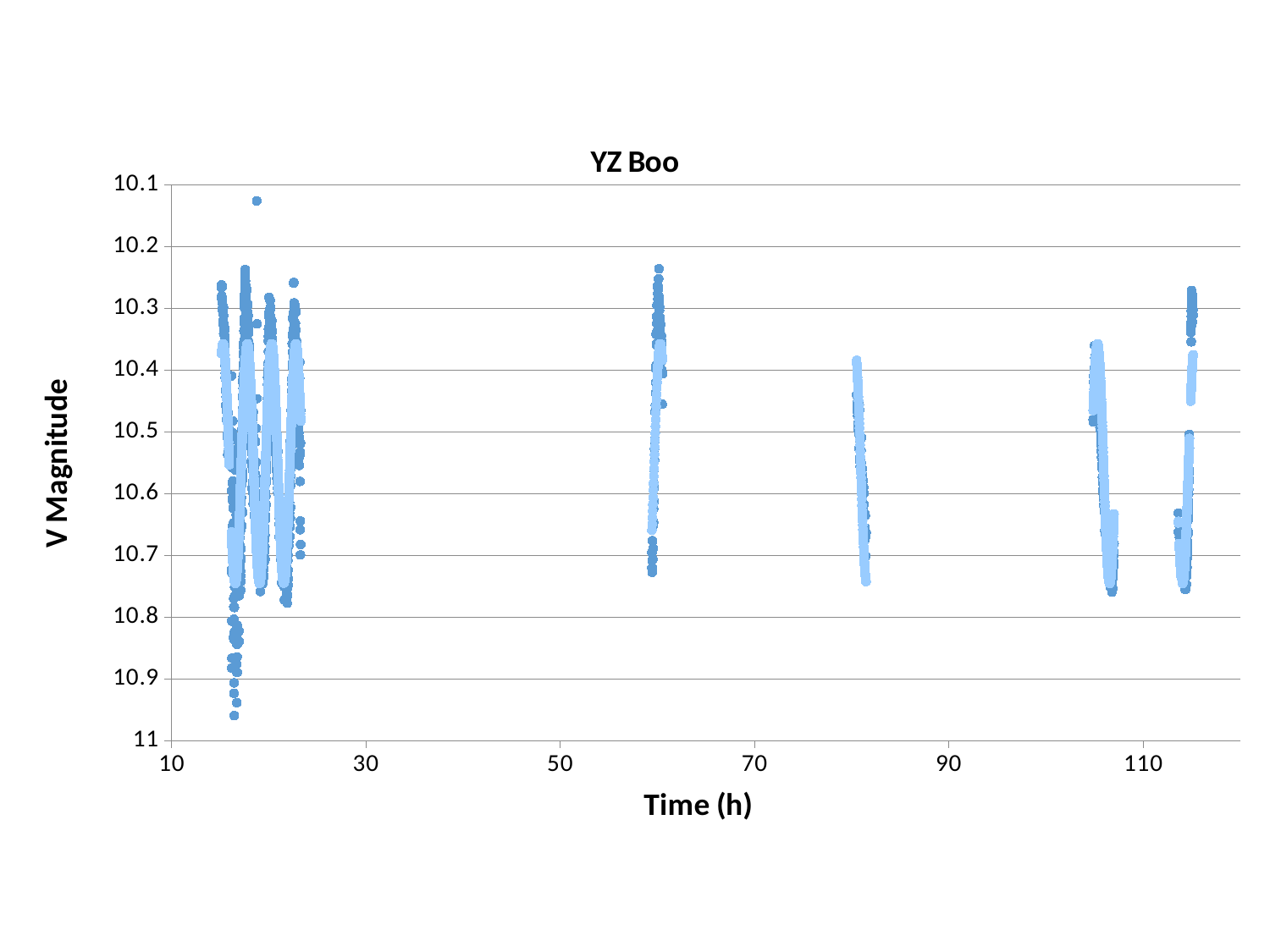
Is the smallest V Magnitude value in the group of points near 114 h greater or less than 10.2? greater Which group of points reaches a larger V Magnitude value, the one near 16 h or the one near 81 h? the one near 16 h Is the largest V Magnitude value in the group of points near 81 h greater or less than 10.7? greater Is the smallest V Magnitude value in the group of points near 81 h greater or less than 10.3? greater What is the label of the vertical axis? V Magnitude What kind of chart is shown on the slide? scatter chart What is the title of the chart? YZ Boo How many separate groups of observations are plotted along the Time axis? 5